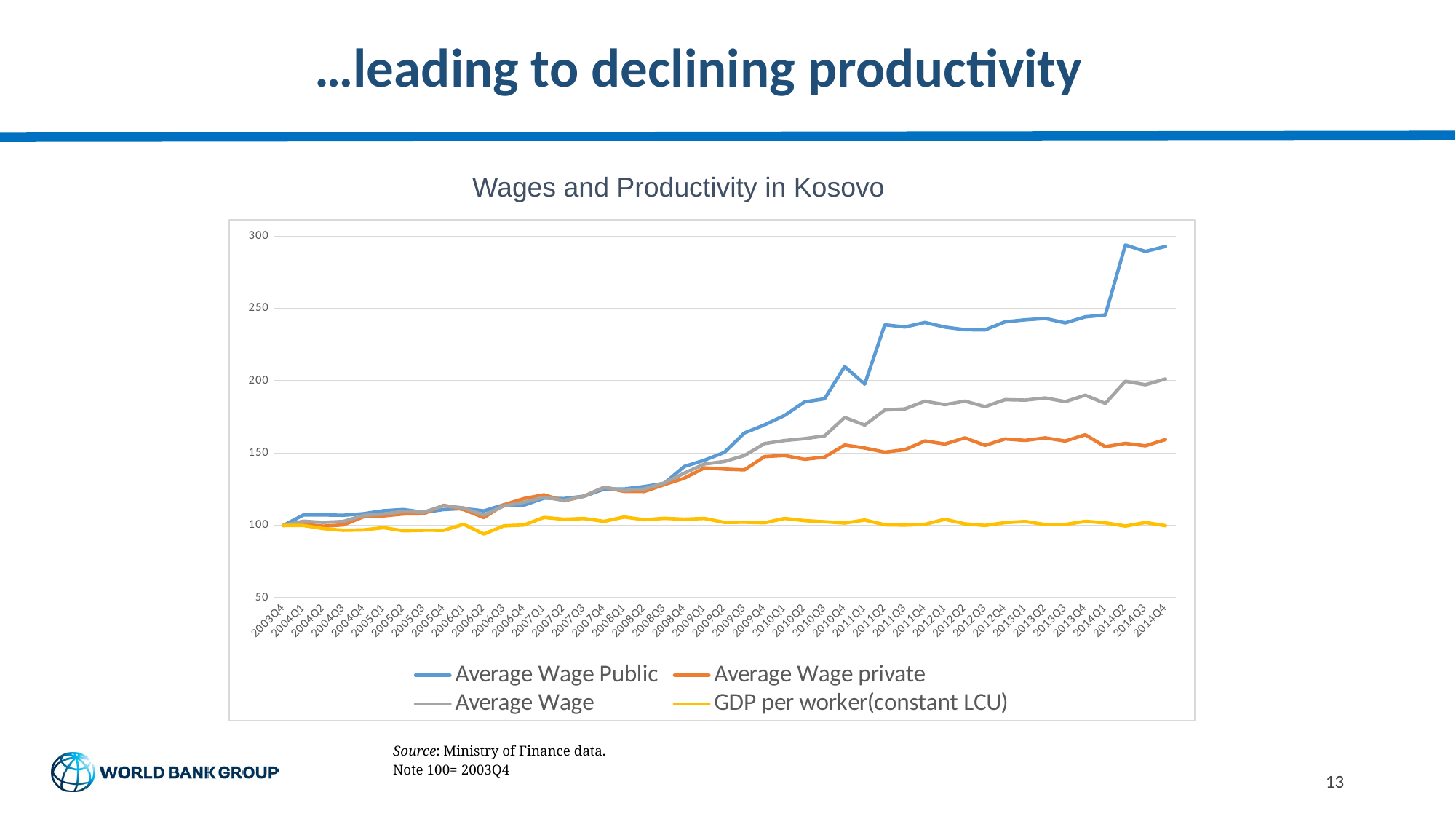
How many series does the legend list? 4 Which series has the highest value at 2014Q4? Average Wage Public Is the value for Average Wage Public at 2014Q4 greater or less than 250? greater What is the value of all four series at 2003Q4? 100 How many quarters are shown on the x axis? 45 Which series has the lowest value at 2014Q4? GDP per worker(constant LCU) Which series is plotted in yellow? GDP per worker(constant LCU) Does the Average Wage Public series generally rise or fall from 2003Q4 to 2014Q4? rise What kind of chart is shown on the slide? line chart What is the title of the chart? Wages and Productivity in Kosovo Is the value for GDP per worker(constant LCU) at 2014Q4 greater or less than 150? less At 2014Q4, which is larger: Average Wage or Average Wage private? Average Wage